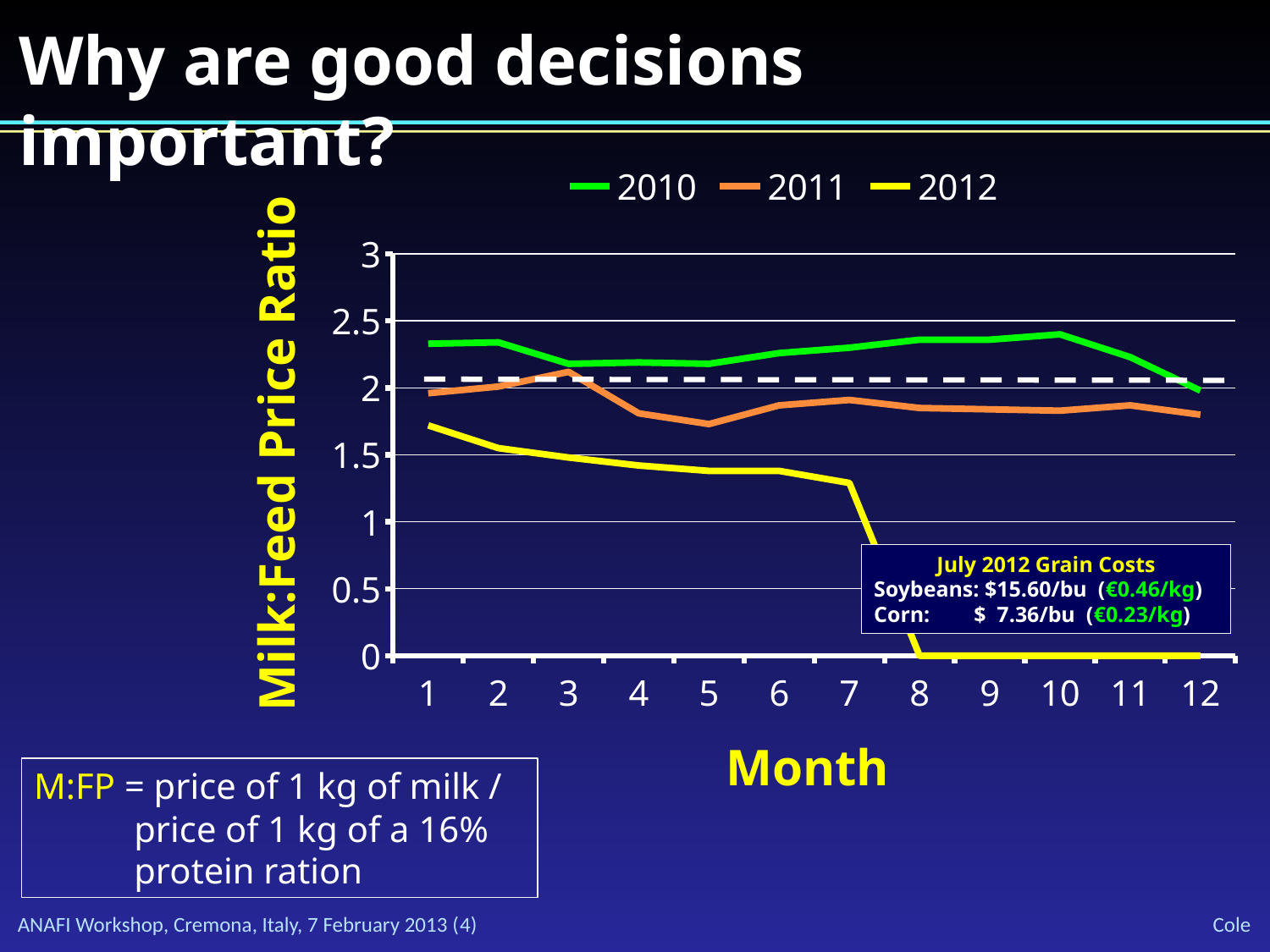
Is the value for 2012 in month 1 greater or less than 2? less Is the value for 2012 in month 7 greater or less than 1.5? less Does the 2012 line rise or fall from month 1 to month 7? fall Is the value for 2010 in month 1 greater or less than 2? greater What kind of chart is shown on the slide? line chart How many months are shown along the x axis? 12 Which series has the highest value in month 10? 2010 What is the title of the y axis? Milk:Feed Price Ratio In month 4, which series has the larger value, 2010 or 2012? 2010 In month 3, which series has the larger value, 2011 or 2012? 2011 How many series does the legend list? 3